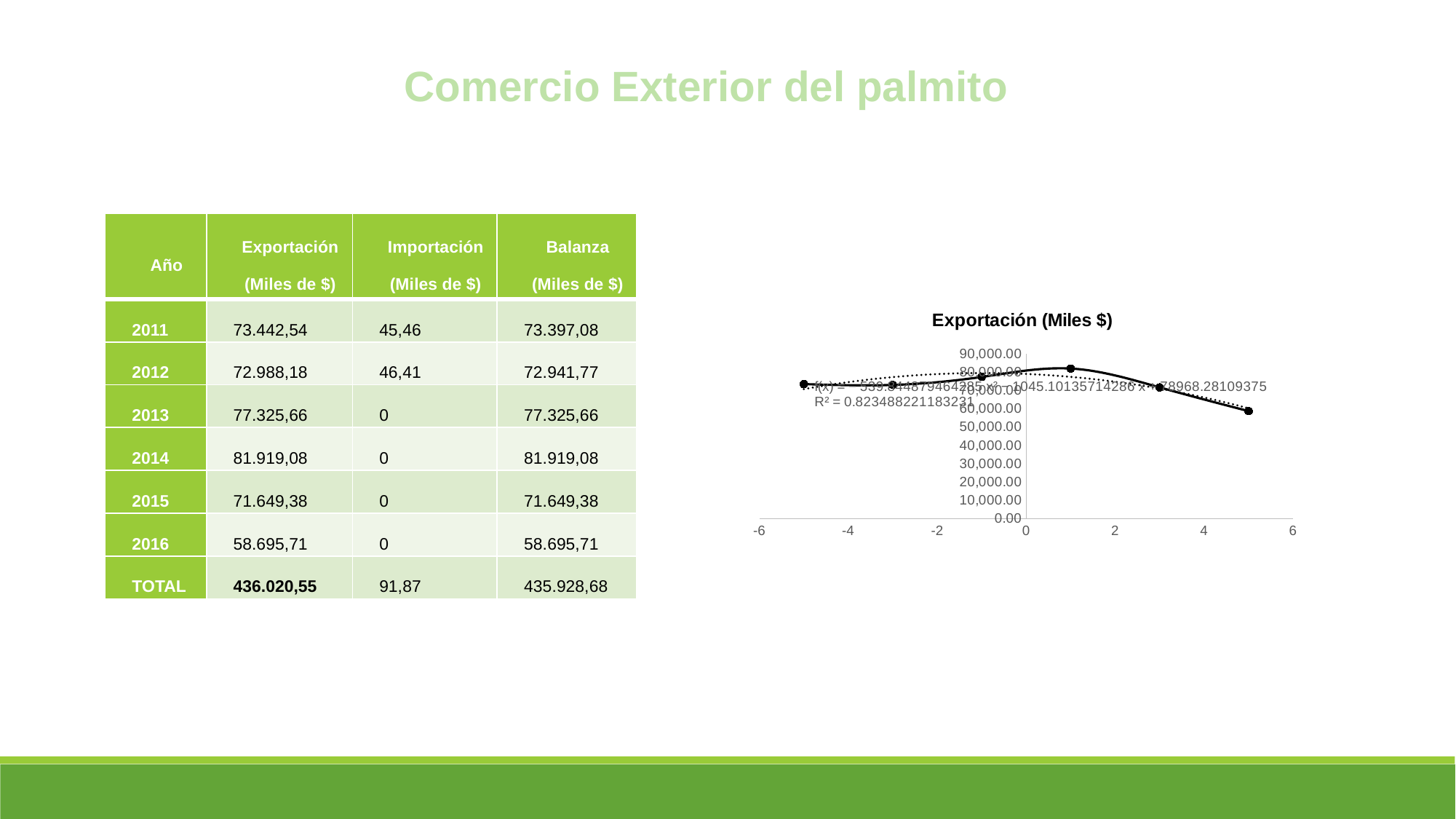
Is the value at x = 5 greater or less than 50,000.00? greater Do the values rise or fall from x = 1 to x = 5? fall What kind of chart is shown on the slide? line chart At which x value does the chart reach its highest point? 1 Is the value at x = -5 greater or less than 60,000.00? greater What is the title of the chart? Exportación (Miles $) Which is larger, the value at x = -5 or the value at x = 5? x = -5 Is the value at x = 1 greater or less than 70,000.00? greater Which is larger, the value at x = 1 or the value at x = 5? x = 1 At which x value does the chart reach its lowest point? 5 What is the R² value printed on the chart? 0.823488221183231 How many data points are plotted on the chart? 6